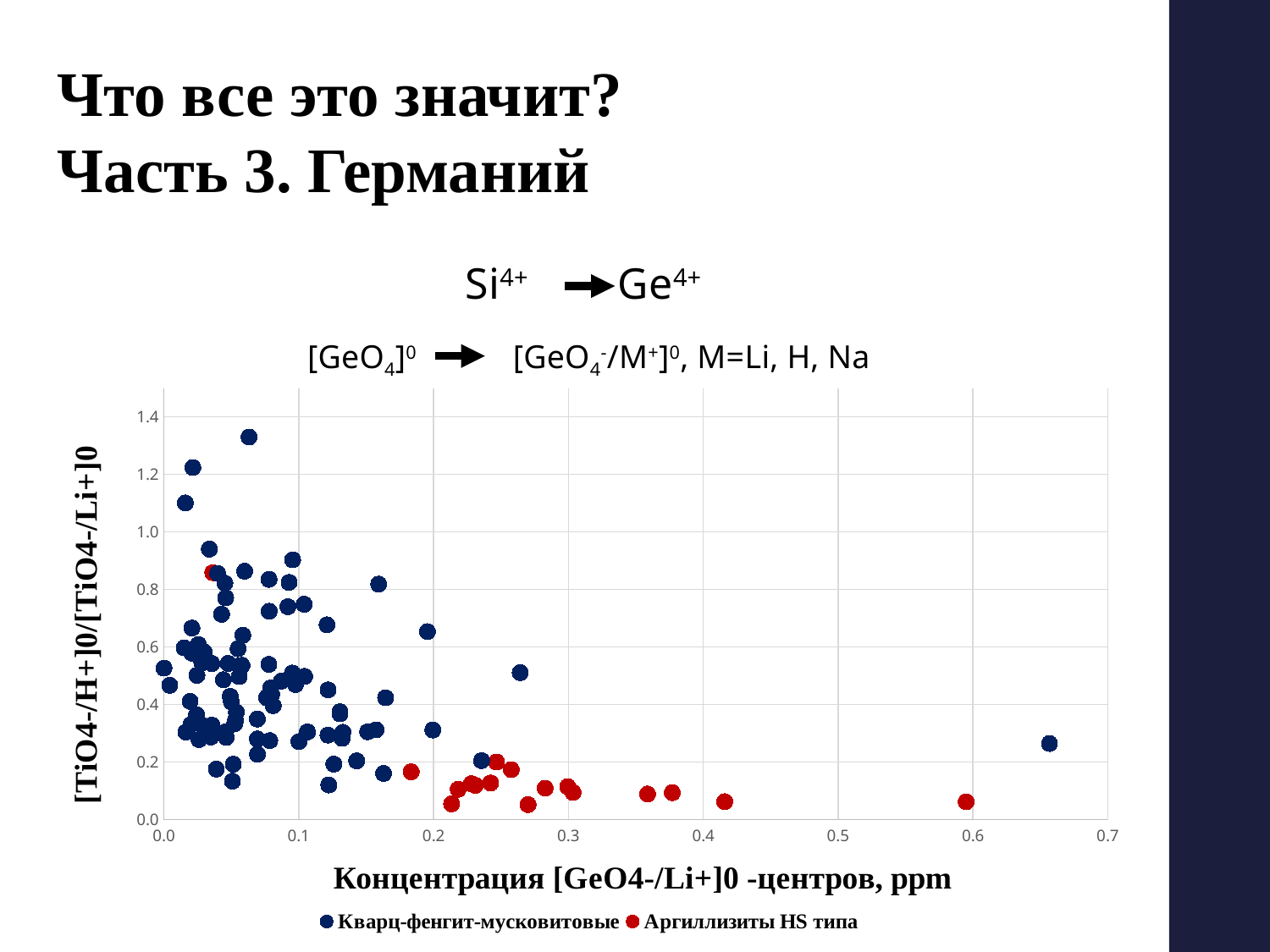
Is the largest x value plotted on the chart greater or less than 0.6? greater Is the y value of the Аргиллизиты HS типа point with the largest x value greater or less than 0.2? less What is the title of the x axis? Концентрация [GeO4-/Li+]0 -центров, ppm What are the two series named in the legend? Кварц-фенгит-мусковитовые and Аргиллизиты HS типа What kind of chart is shown on the slide? Scatter chart Is the highest y value among the Кварц-фенгит-мусковитовые points greater or less than 1.2? greater How many series does the legend list? 2 Which series reaches higher values on the y axis, Кварц-фенгит-мусковитовые or Аргиллизиты HS типа? Кварц-фенгит-мусковитовые Which series contains the point with the largest x value on the chart? Кварц-фенгит-мусковитовые As the concentration on the x axis increases, do the y values generally rise or fall? Fall